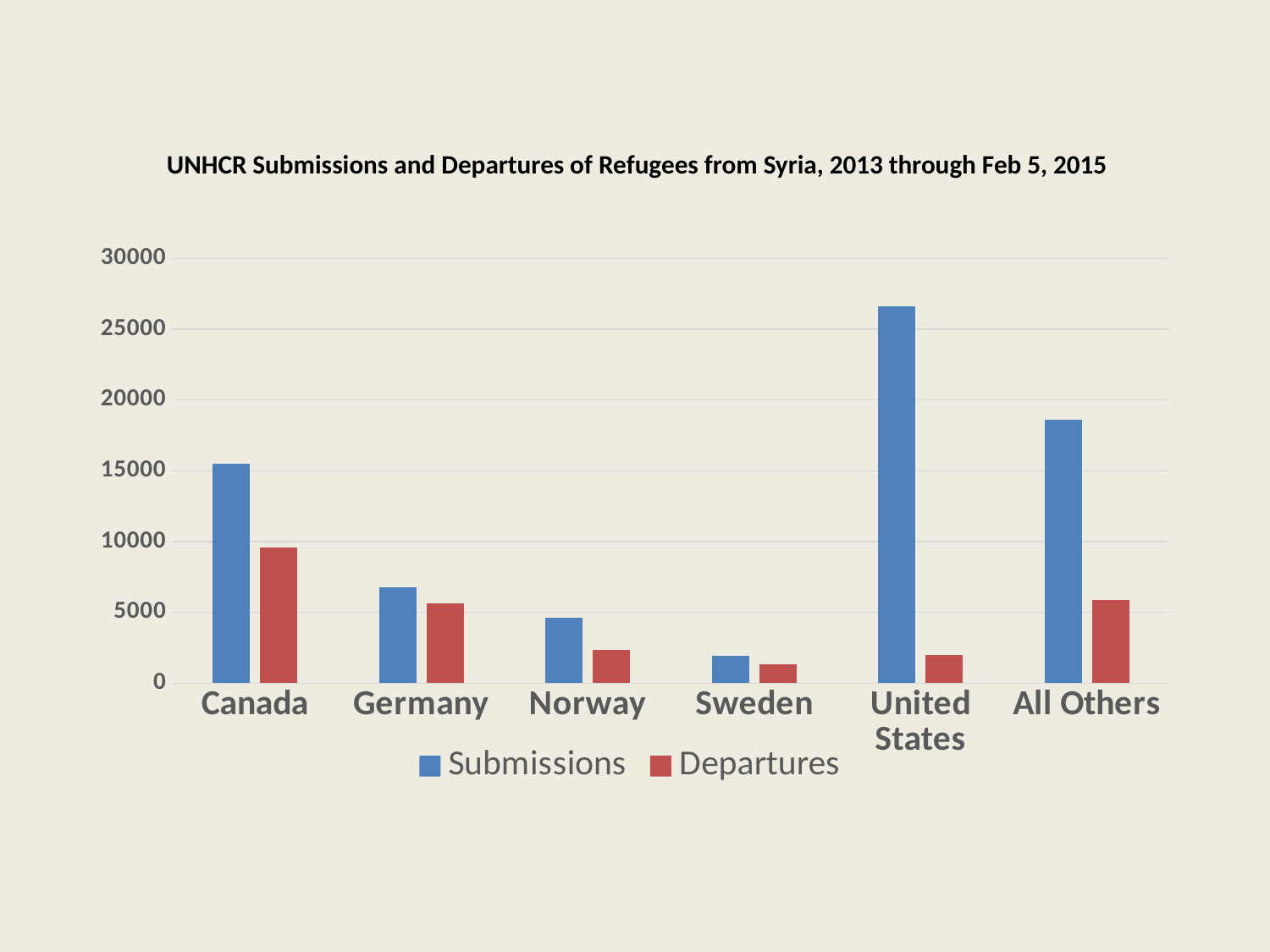
Is the Departures value for Germany greater or less than 5000? greater Which category has the highest Departures value? Canada Which is larger, the Departures value for Canada or the Departures value for Germany? Canada Is the Submissions value for All Others greater or less than 20000? less What is the title of the chart? UNHCR Submissions and Departures of Refugees from Syria, 2013 through Feb 5, 2015 How many series does the legend list? 2 What kind of chart is shown on the slide? bar chart Which category has the highest Submissions value? United States How many categories are shown on the x axis? 6 Which category has the lowest Departures value? Sweden Is the Submissions value for United States greater or less than 25000? greater Which category has the lowest Submissions value? Sweden